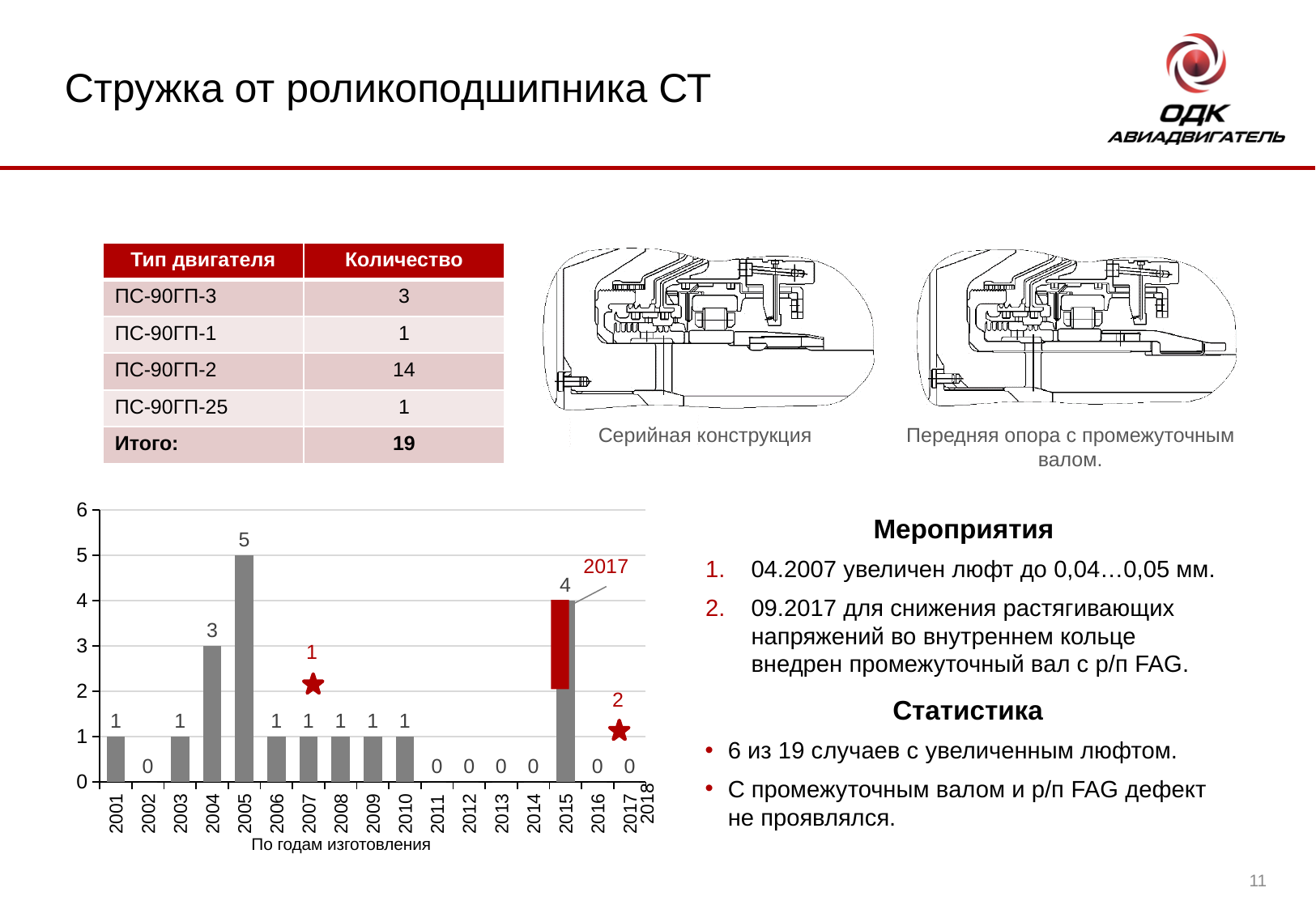
What is the value for 2004 in the bar chart? 3 Which year has the highest value in the bar chart? 2005 How many years in the bar chart have a value of 0? 7 What is the value for 2002 in the bar chart? 0 Do the values in the bar chart rise or fall from 2003 to 2005? rise What is the difference between the values for 2005 and 2004 in the bar chart? 2 What is the value for 2005 in the bar chart? 5 What is the value for 2015 in the bar chart? 4 What is the difference between the values for 2005 and 2015 in the bar chart? 1 What kind of chart is shown on the slide? bar chart Which is larger in the bar chart, the value for 2004 or the value for 2015? 2015 What is the x-axis title of the bar chart? По годам изготовления